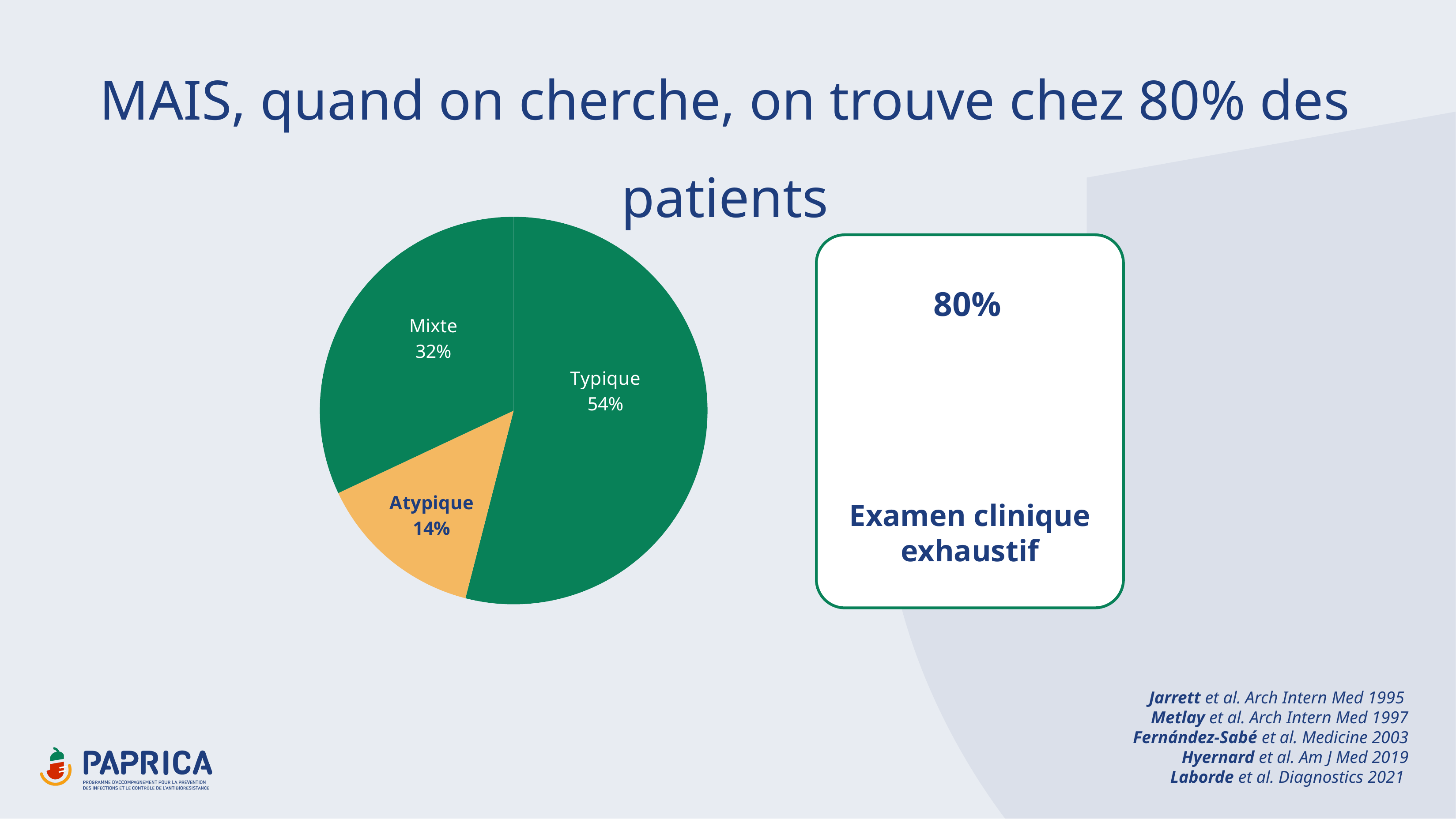
What is the value for Typique in the pie chart? 54% Which is larger in the pie chart, Mixte or Atypique? Mixte What is the difference between the Mixte and Atypique shares in the pie chart? 18% What kind of chart is shown on the slide? pie chart What is the value for Atypique in the pie chart? 14% What is the value for Mixte in the pie chart? 32% What share of the pie does the Atypique slice represent? 14% What is the difference between the Typique and Mixte shares in the pie chart? 22% How many slices does the pie chart have? 3 Which slice of the pie chart is the smallest? Atypique Which slice of the pie chart is the largest? Typique Which slice of the pie chart is coloured orange? Atypique